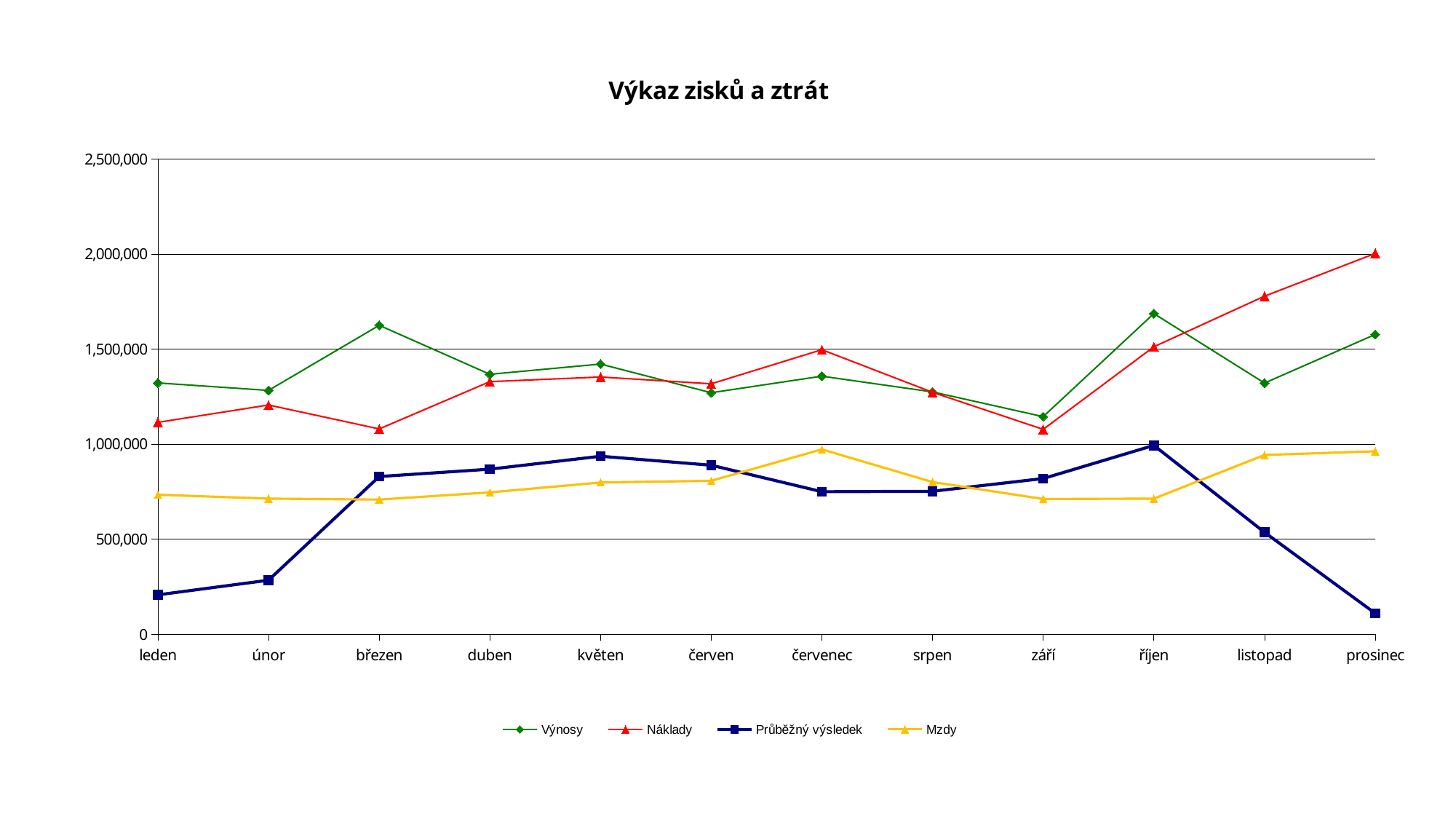
Which is larger in prosinec, Mzdy or Průběžný výsledek? Mzdy In which month is the Náklady series highest? prosinec Is the value of Průběžný výsledek in leden greater or less than 500,000? less How many series does the legend list? 4 Which is larger in březen, Výnosy or Náklady? Výnosy How many months are shown along the x axis? 12 What kind of chart is shown on the slide? line chart Is the value of Náklady in listopad greater or less than 1,500,000? greater In which month is the Výnosy series highest? říjen What is the title of the chart? Výkaz zisků a ztrát In which month is the Průběžný výsledek series lowest? prosinec Does the Náklady series rise or fall from září to prosinec? rise